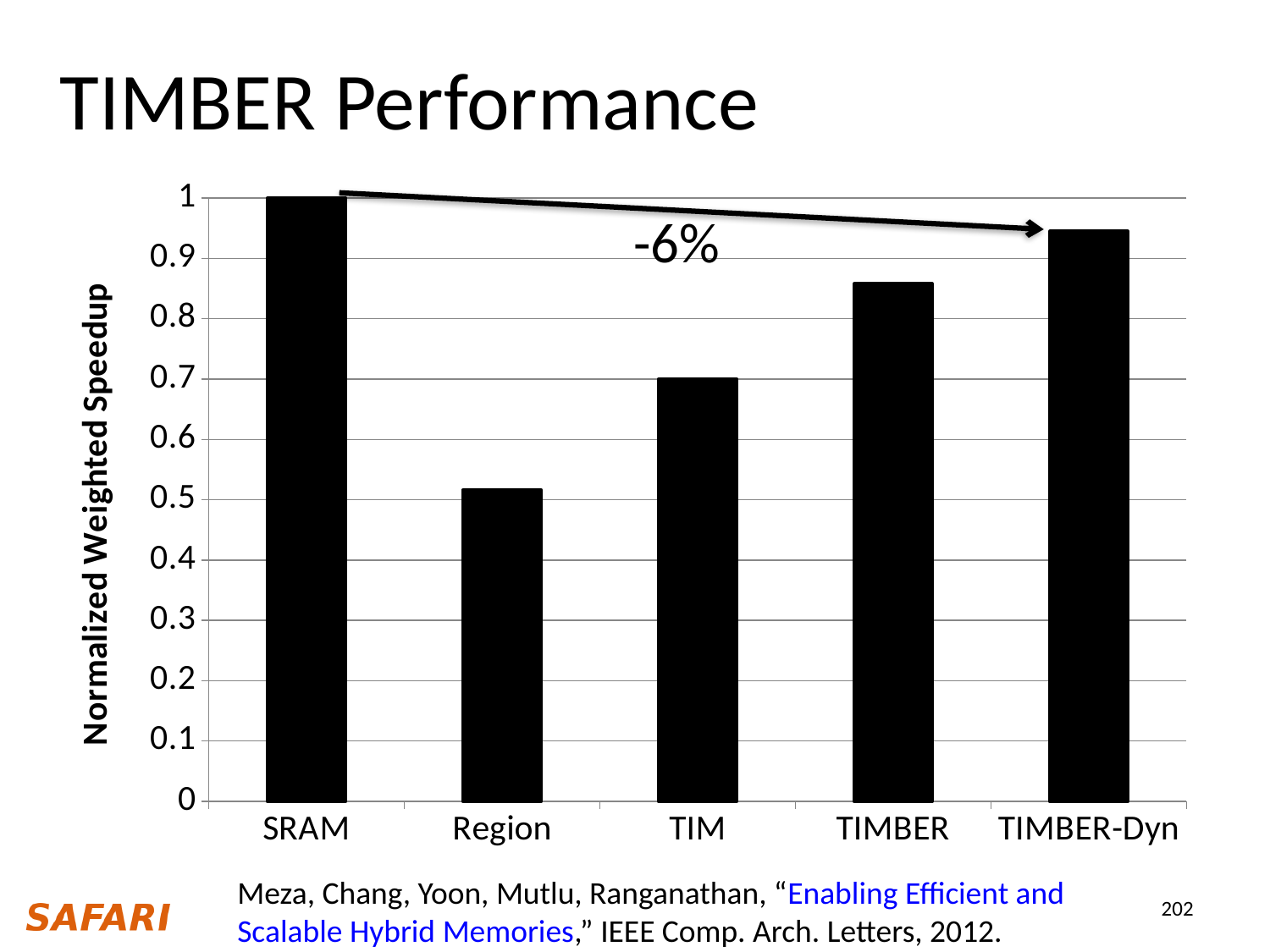
What is the normalized weighted speedup for SRAM? 1 Is the value for TIMBER-Dyn greater or less than 0.9? greater How many categories are plotted on the x axis? 5 What kind of chart is shown on the slide? bar chart Which category has the highest normalized weighted speedup? SRAM Which has a higher normalized weighted speedup, TIM or TIMBER? TIMBER Is the value for Region greater or less than 0.6? less What is the label on the y axis of the chart? Normalized Weighted Speedup Which category has the lowest normalized weighted speedup? Region Is the value for TIMBER greater or less than 0.8? greater Which has a higher normalized weighted speedup, TIMBER or TIMBER-Dyn? TIMBER-Dyn